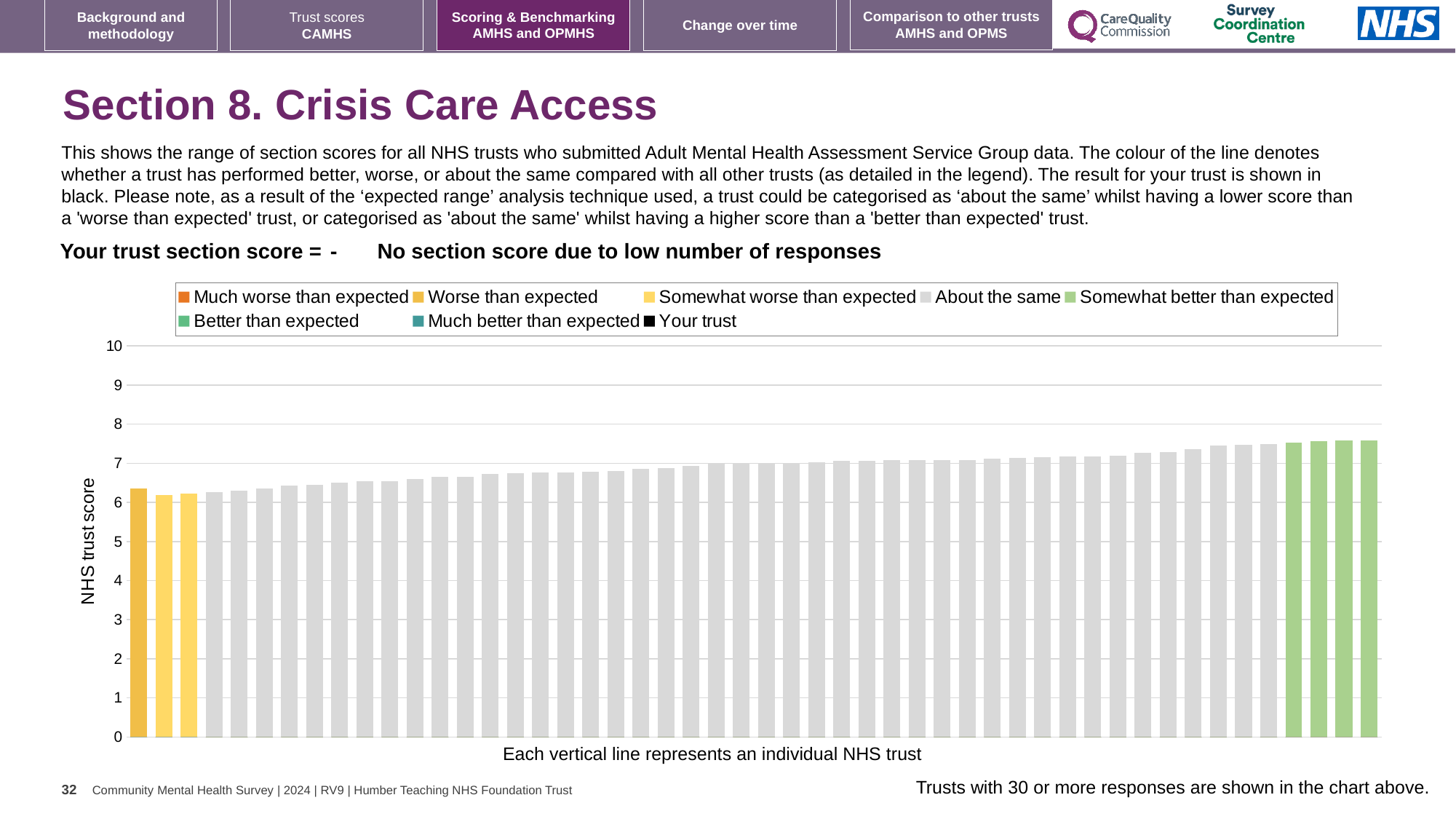
What is the highest value shown on the vertical axis? 10 Do the bar values rise or fall from left to right along the x axis? Rise Is the value of the shortest bar greater or less than 6? greater What colour does the legend use for 'Your trust'? Black Is the value of the tallest bar greater or less than 8? less What kind of chart is shown on the slide? Bar chart Is the value of the rightmost bar greater or less than 7? greater How many bars are coloured green (somewhat better than expected)? 4 What is the label on the vertical axis of the chart? NHS trust score How many bars are coloured yellow (worse or somewhat worse than expected)? 3 How many entries does the chart legend list? 8